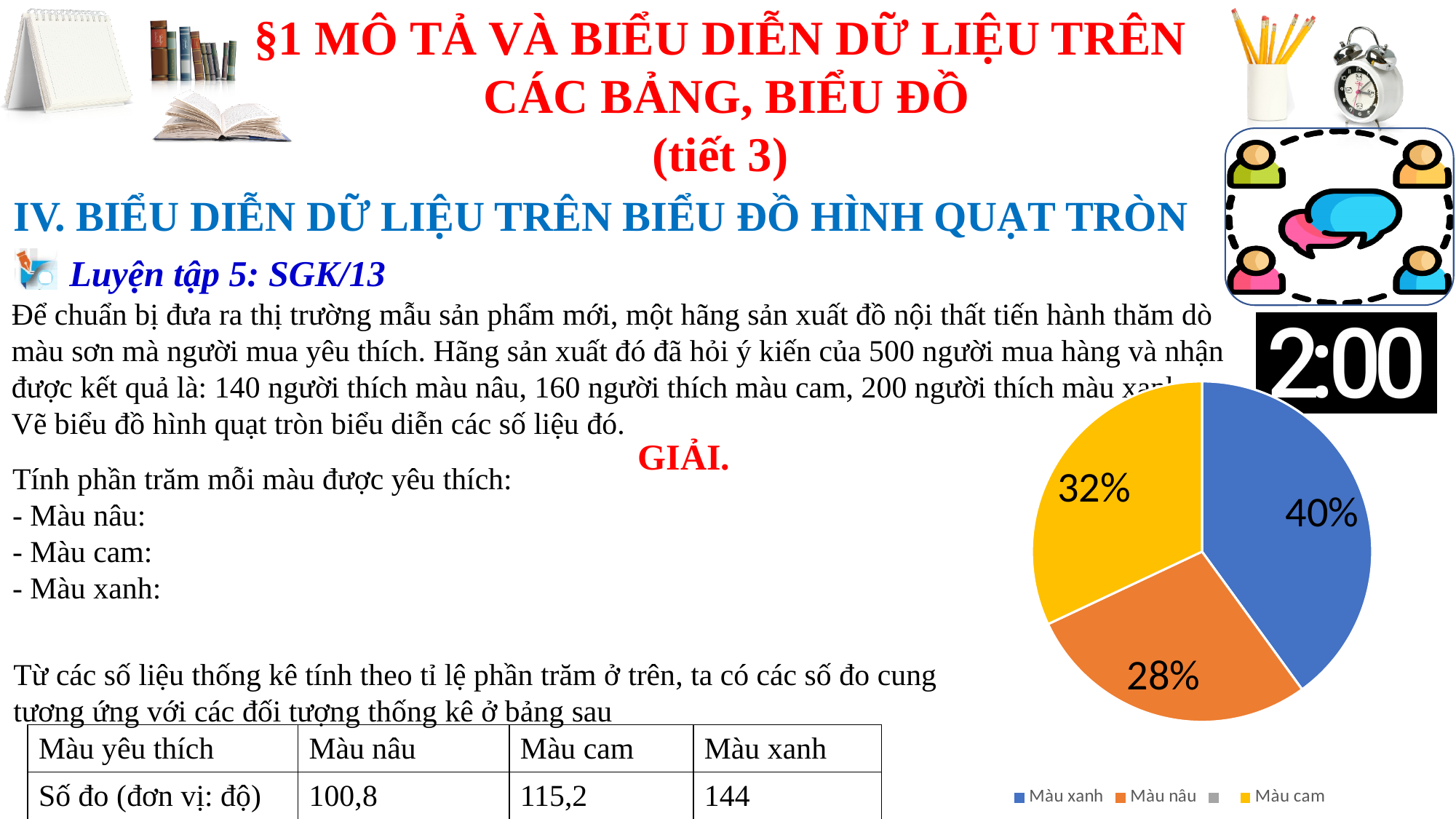
What type of chart is shown on the slide? Pie chart What do the three percentages in the pie chart add up to? 100% Which slice is larger in the pie chart, Màu cam or Màu nâu? Màu cam How many percentage points larger is the Màu xanh slice than the Màu nâu slice? 12% Which colour category has the smallest slice in the pie chart? Màu nâu How many slices does the pie chart have? 3 What is the difference between the Màu cam and Màu nâu percentages in the pie chart? 4% What percentage does the Màu xanh slice show in the pie chart? 40% What percentage does the Màu nâu slice show in the pie chart? 28% What percentage does the Màu cam slice show in the pie chart? 32% Which colour category has the largest slice in the pie chart? Màu xanh What colour is the Màu xanh slice in the pie chart? Blue